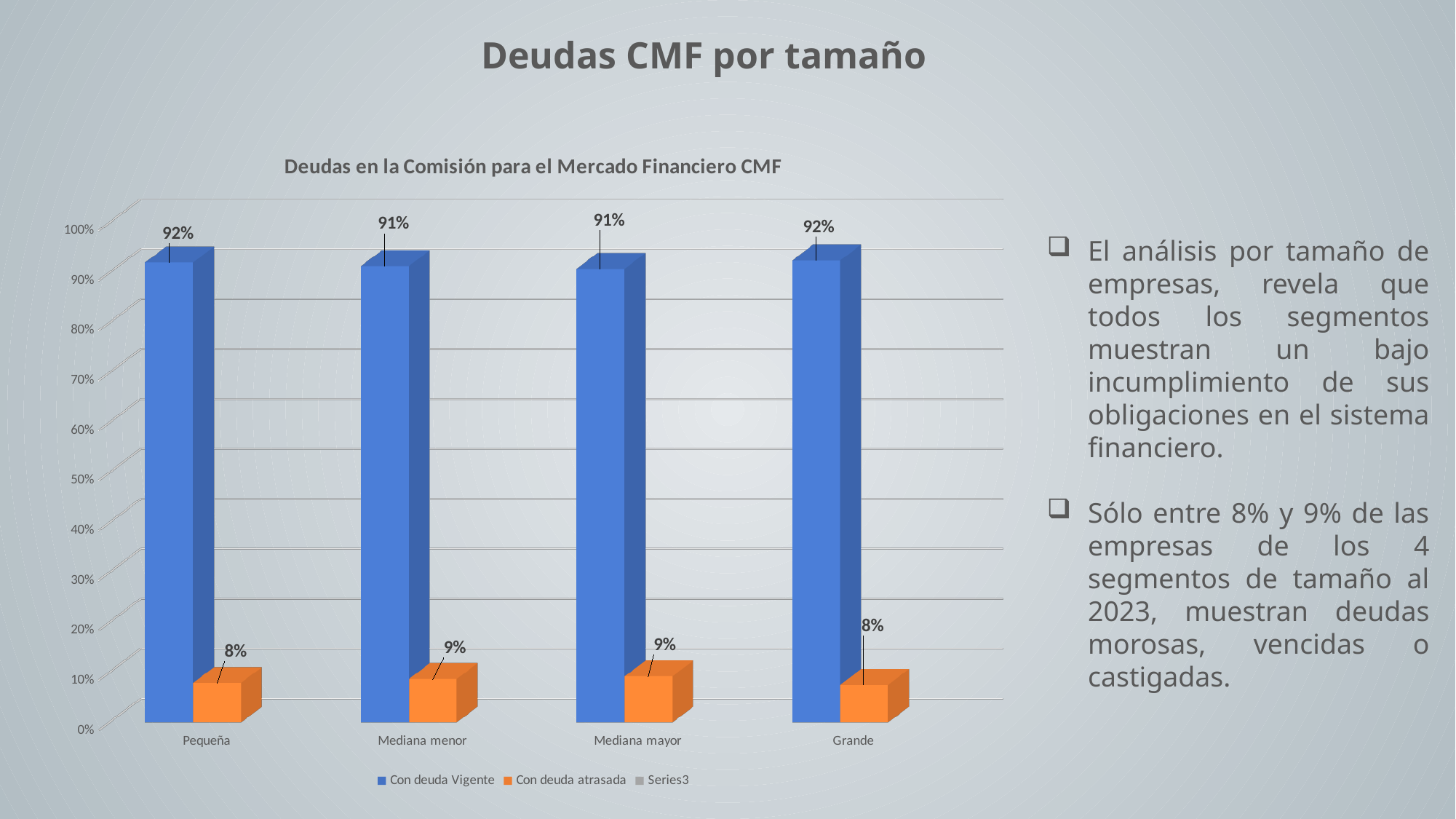
What is the value for 'Con deuda Vigente' for Mediana mayor? 91% How many series does the legend list? 3 What is the title of the chart? Deudas en la Comisión para el Mercado Financiero CMF What kind of chart is shown on the slide? Bar chart What is the value for 'Con deuda Vigente' for Pequeña? 92% Which is larger for Mediana mayor: 'Con deuda Vigente' or 'Con deuda atrasada'? Con deuda Vigente How many company size categories are shown on the x axis? 4 What is the difference between 'Con deuda atrasada' for Mediana menor and for Grande? 1% What is the difference between 'Con deuda Vigente' and 'Con deuda atrasada' for Pequeña? 84% What is the value for 'Con deuda atrasada' for Mediana menor? 9% What is the value for 'Con deuda atrasada' for Grande? 8% Is the value for 'Con deuda Vigente' for Grande greater or less than 50%? greater